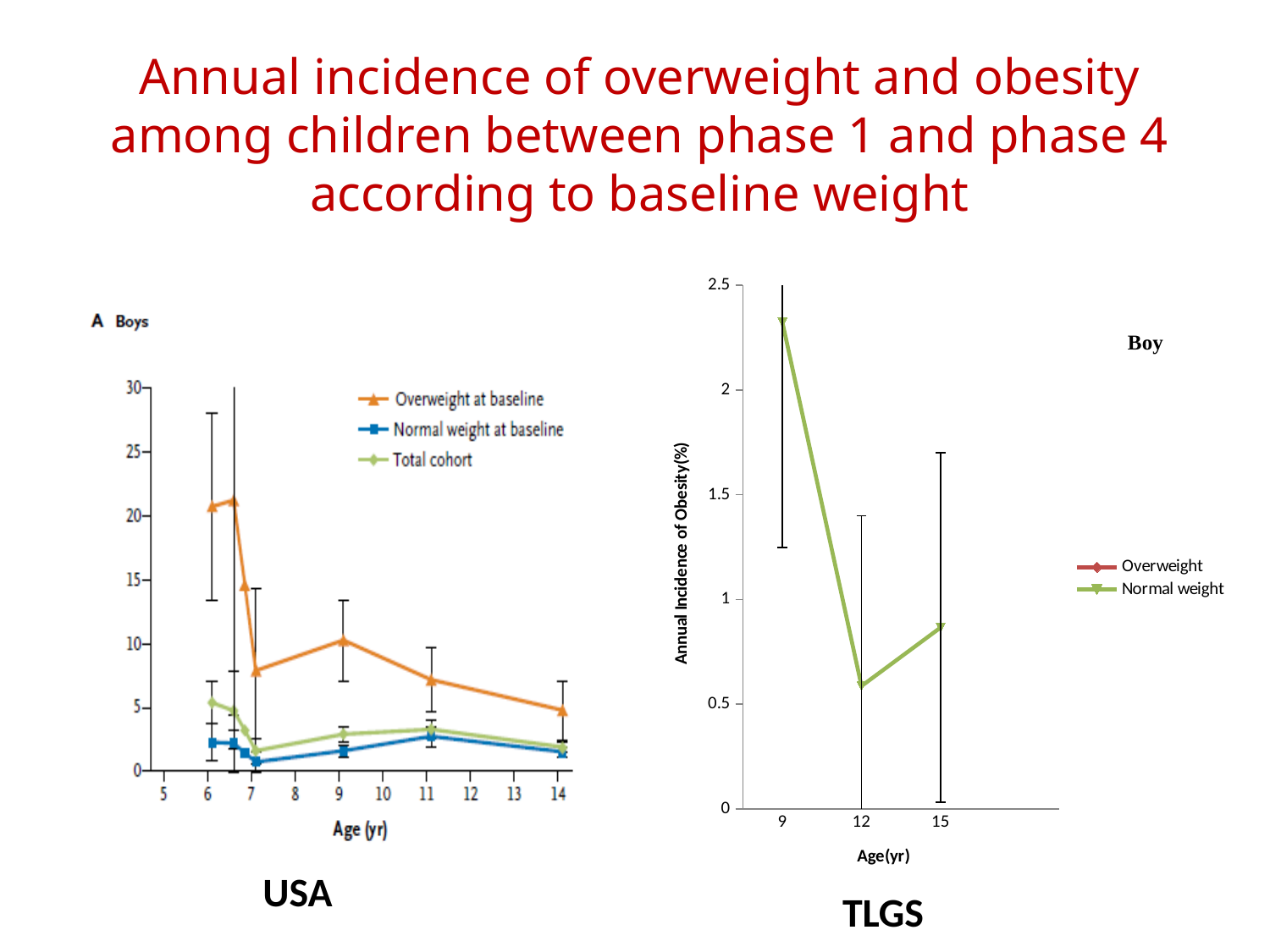
What is the y-axis title of the TLGS chart? Annual Incidence of Obesity(%) How many series does the legend of the TLGS chart list? 2 In the TLGS chart, how many age points are plotted on the x axis? 3 In the TLGS chart, at which age is the Normal weight incidence lowest? 12 In the TLGS chart, at which age is the Normal weight incidence highest? 9 In the TLGS chart, is the Normal weight value at age 9 greater or less than 2? greater In the TLGS chart, is the Normal weight value at age 12 greater or less than 1? less What kind of chart is the TLGS chart on the right of the slide? line chart In the TLGS chart, does the Normal weight line rise or fall from age 9 to age 12? fall In the USA chart, which series has the highest values across the ages shown? Overweight at baseline In the USA chart, is the Overweight at baseline value at age 11 greater or less than 5? greater How many series does the legend of the USA chart list? 3